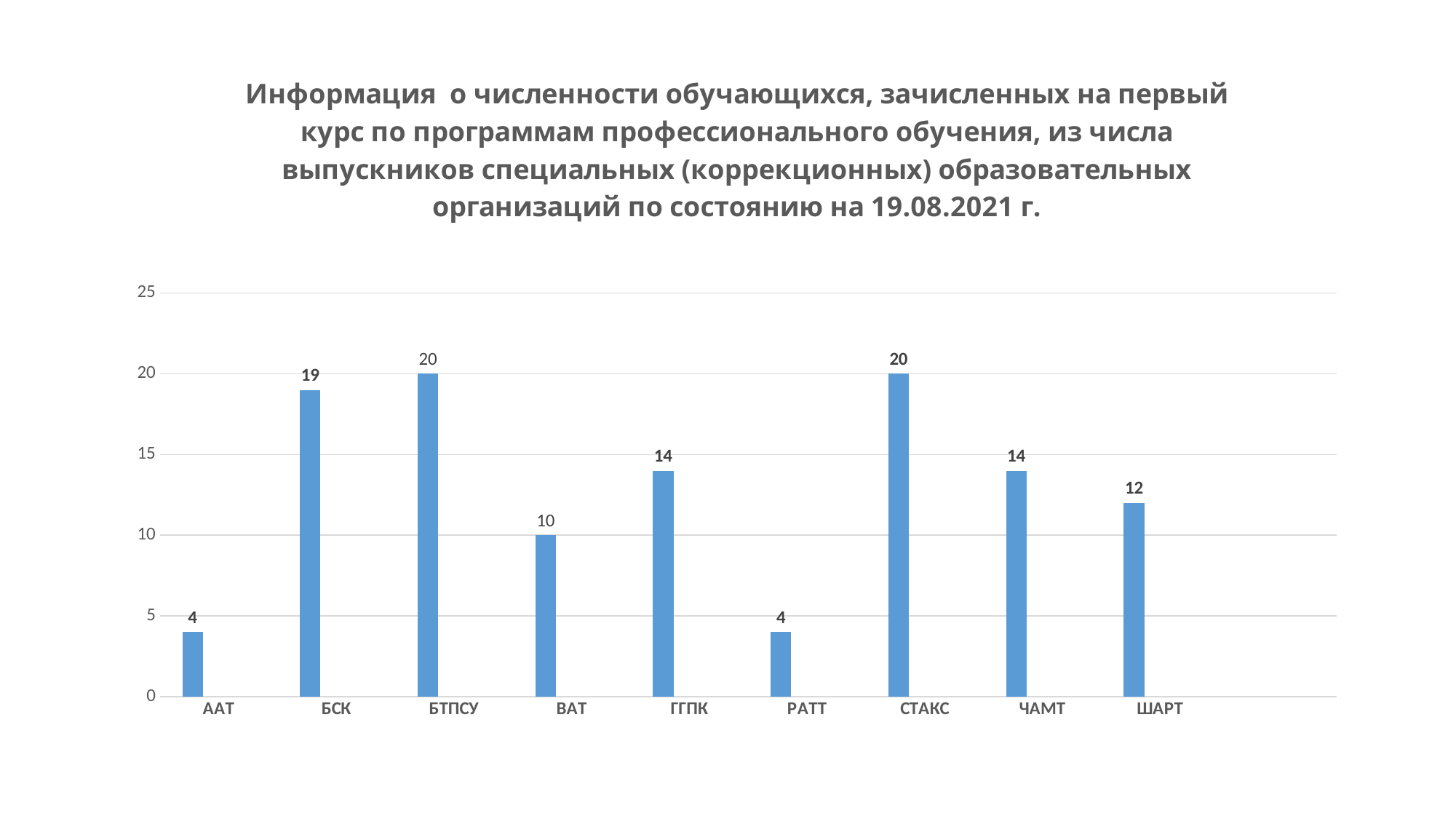
How many categories are shown on the x axis? 9 What is the highest value shown on the vertical axis? 25 What is the value for ВАТ? 10 What kind of chart is shown on the slide? bar chart Which categories have the lowest value? ААТ and РАТТ What is the value for БСК? 19 Which categories have the highest value? БТПСУ and СТАКС What is the difference between the values for БСК and ШАРТ? 7 What is the difference between the values for БТПСУ and ВАТ? 10 Which is larger, the value for ГГПК or the value for ШАРТ? ГГПК Is the value for ЧАМТ greater or less than 10? greater What is the value for ШАРТ? 12